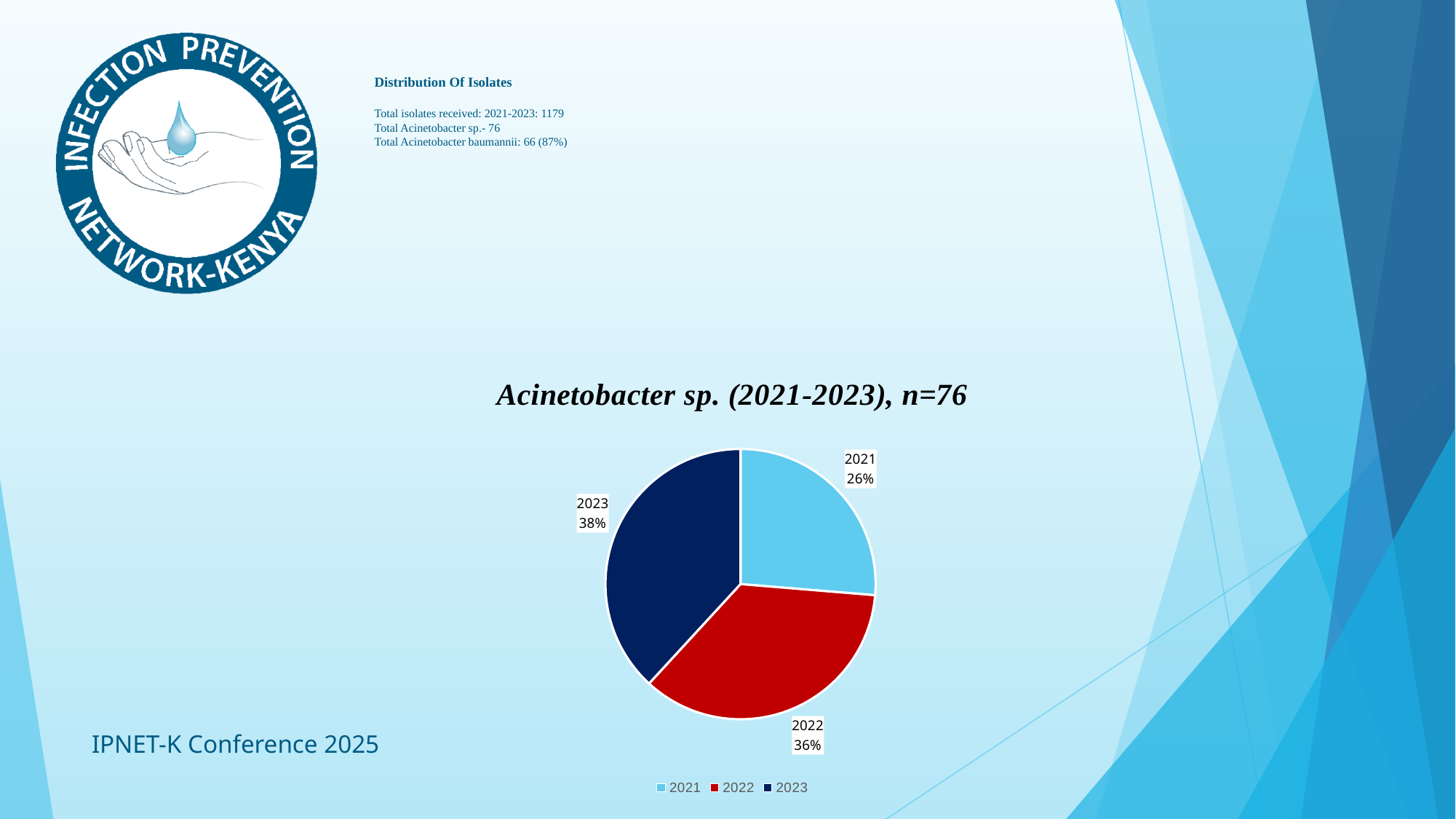
How many slices does the pie chart have? 3 What share of the pie does 2023 represent? 38% What is the difference in percentage points between the 2023 slice and the 2021 slice? 12 Which year has the largest slice of the pie? 2023 What colour is the 2022 slice in the pie chart? Red Which slice is larger, 2021 or 2022? 2022 What type of chart is shown on the slide? Pie chart Which year has the smallest slice of the pie? 2021 What share of the pie does 2021 represent? 26% What is the title of the chart? Acinetobacter sp. (2021-2023), n=76 How many entries does the legend list? 3 What share of the pie does 2022 represent? 36%